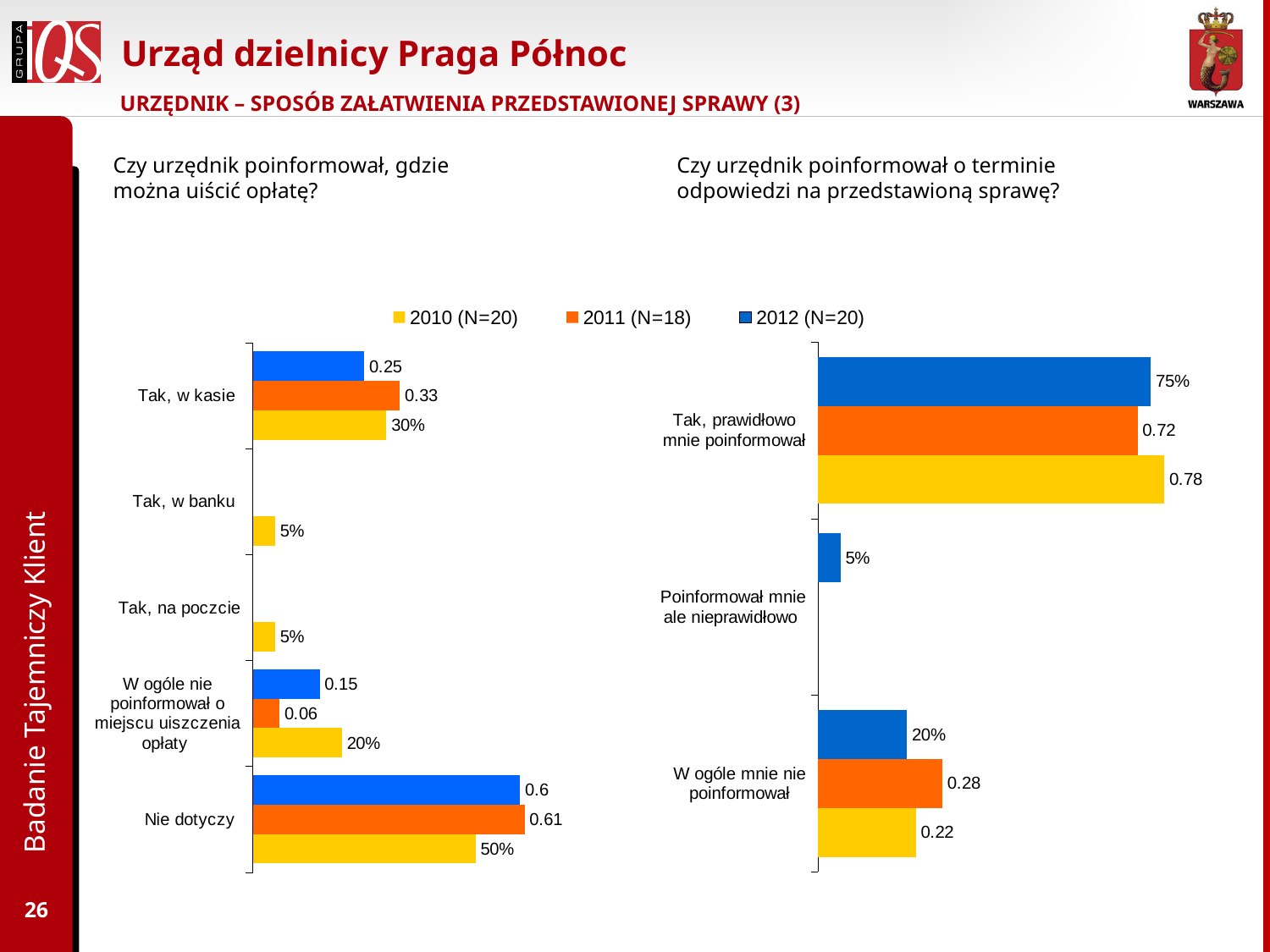
How many series does the legend list for the charts on this slide? 3 On the left chart (Czy urzędnik poinformował, gdzie można uiścić opłatę?), what is the 2012 (N=20) value for 'Tak, w kasie'? 0.25 On the left chart (Czy urzędnik poinformował, gdzie można uiścić opłatę?), what is the difference between the 2012 (N=20) values for 'Nie dotyczy' and 'Tak, w kasie'? 0.35 On the left chart (Czy urzędnik poinformował, gdzie można uiścić opłatę?), what is the 2010 (N=20) value for 'Nie dotyczy'? 50% On the left chart (Czy urzędnik poinformował, gdzie można uiścić opłatę?), which is larger for 'W ogóle nie poinformował o miejscu uiszczenia opłaty': the 2012 (N=20) value or the 2011 (N=18) value? 2012 (N=20) On the left chart (Czy urzędnik poinformował, gdzie można uiścić opłatę?), which category has the lowest 2011 (N=18) value among those with a 2011 bar? W ogóle nie poinformował o miejscu uiszczenia opłaty On the right chart (Czy urzędnik poinformował o terminie odpowiedzi na przedstawioną sprawę?), which category has the highest 2010 (N=20) value? Tak, prawidłowo mnie poinformował On the right chart (Czy urzędnik poinformował o terminie odpowiedzi na przedstawioną sprawę?), what is the difference between the 2010 (N=20) and 2011 (N=18) values for 'Tak, prawidłowo mnie poinformował'? 0.06 How many categories are shown on the left chart (Czy urzędnik poinformował, gdzie można uiścić opłatę?)? 5 What kind of chart is the right chart (Czy urzędnik poinformował o terminie odpowiedzi na przedstawioną sprawę?)? Bar chart On the right chart (Czy urzędnik poinformował o terminie odpowiedzi na przedstawioną sprawę?), what is the 2012 (N=20) value for 'Poinformował mnie ale nieprawidłowo'? 5% On the right chart (Czy urzędnik poinformował o terminie odpowiedzi na przedstawioną sprawę?), what is the 2011 (N=18) value for 'W ogóle mnie nie poinformował'? 0.28